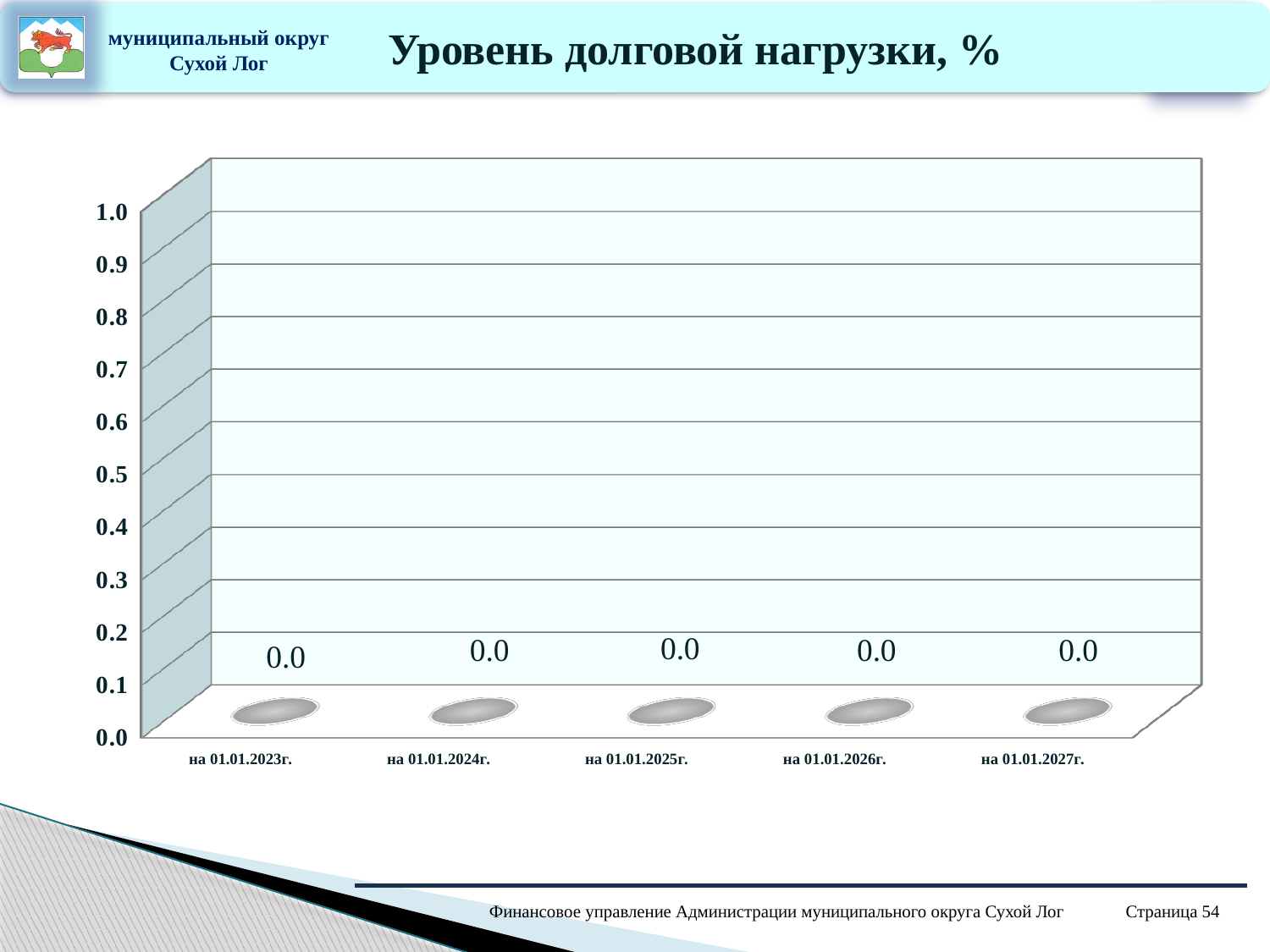
What is the highest value shown on the y axis? 1.0 What is the difference between the values for на 01.01.2027г. and на 01.01.2023г.? 0.0 What is the value for на 01.01.2026г.? 0.0 What is the title of the chart? Уровень долговой нагрузки, % How many categories are shown on the x axis? 5 Is the value for на 01.01.2025г. greater or less than 0.5? less What is the value for на 01.01.2027г.? 0.0 What is the value for на 01.01.2024г.? 0.0 What is the value for на 01.01.2025г.? 0.0 Do the values rise, fall or stay the same from на 01.01.2023г. to на 01.01.2027г.? stay the same What is the value for на 01.01.2023г.? 0.0 What kind of chart is shown on the slide? bar chart